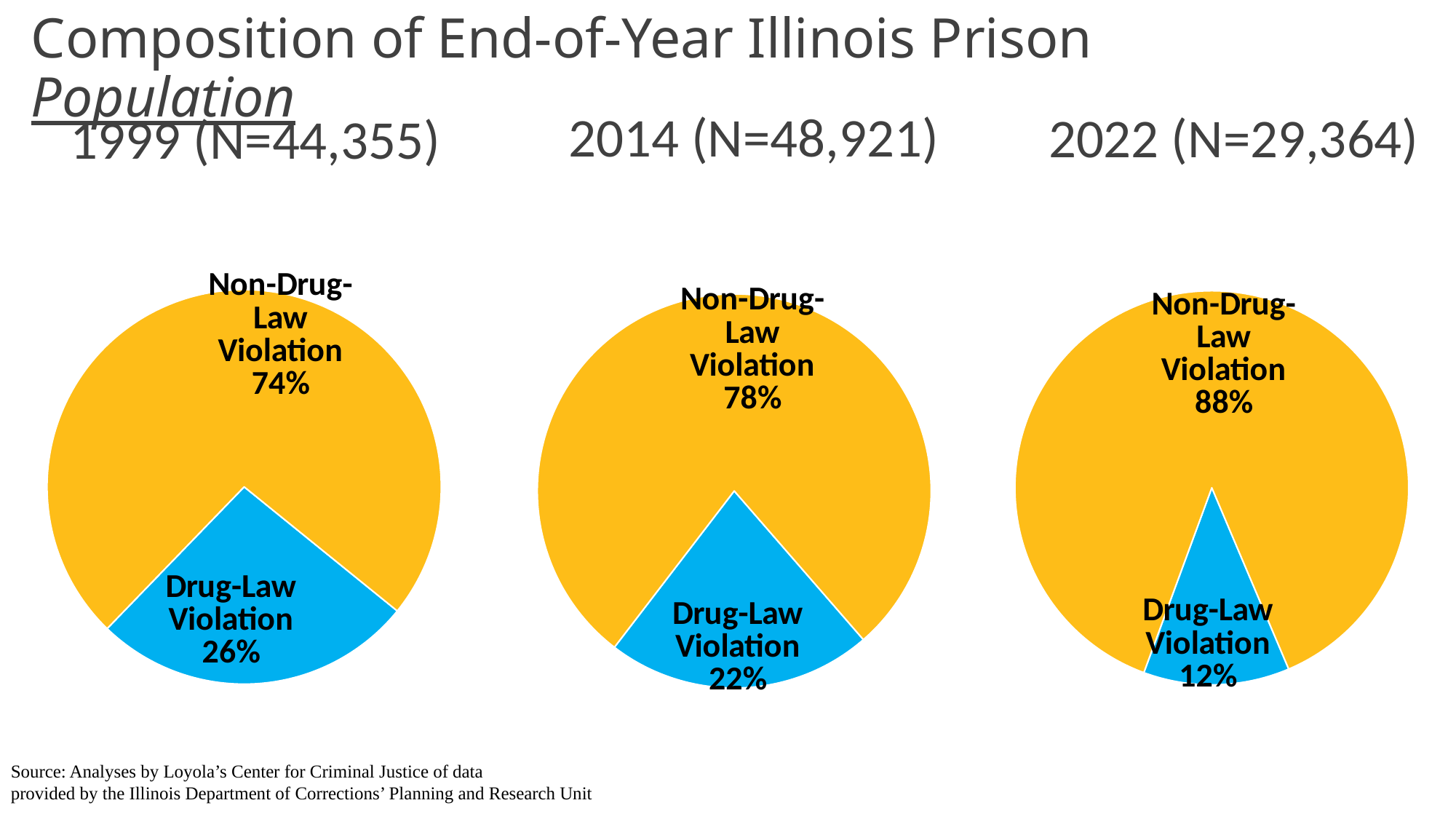
In the 2014 (N=48,921) pie chart, what share of the prison population is Non-Drug-Law Violation? 78% What kind of charts are shown on the slide? Pie charts In the 1999 (N=44,355) pie chart, what share of the prison population is Drug-Law Violation? 26% Which is larger: the Drug-Law Violation share in the 2014 pie chart or the Drug-Law Violation share in the 2022 pie chart? 2014 In the 2022 (N=29,364) pie chart, which category is the smallest? Drug-Law Violation In the 2022 (N=29,364) pie chart, what is the value for Non-Drug-Law Violation? 88% What colour is the Drug-Law Violation slice in the pie charts? Blue What is the difference between the Drug-Law Violation share in the 1999 pie chart and the Drug-Law Violation share in the 2022 pie chart? 14 percentage points In the 1999 (N=44,355) pie chart, what is the value for Non-Drug-Law Violation? 74% In the 2022 (N=29,364) pie chart, what share of the prison population is Drug-Law Violation? 12% In the 2014 (N=48,921) pie chart, which category is the largest? Non-Drug-Law Violation How many categories does each pie chart on the slide show? 2